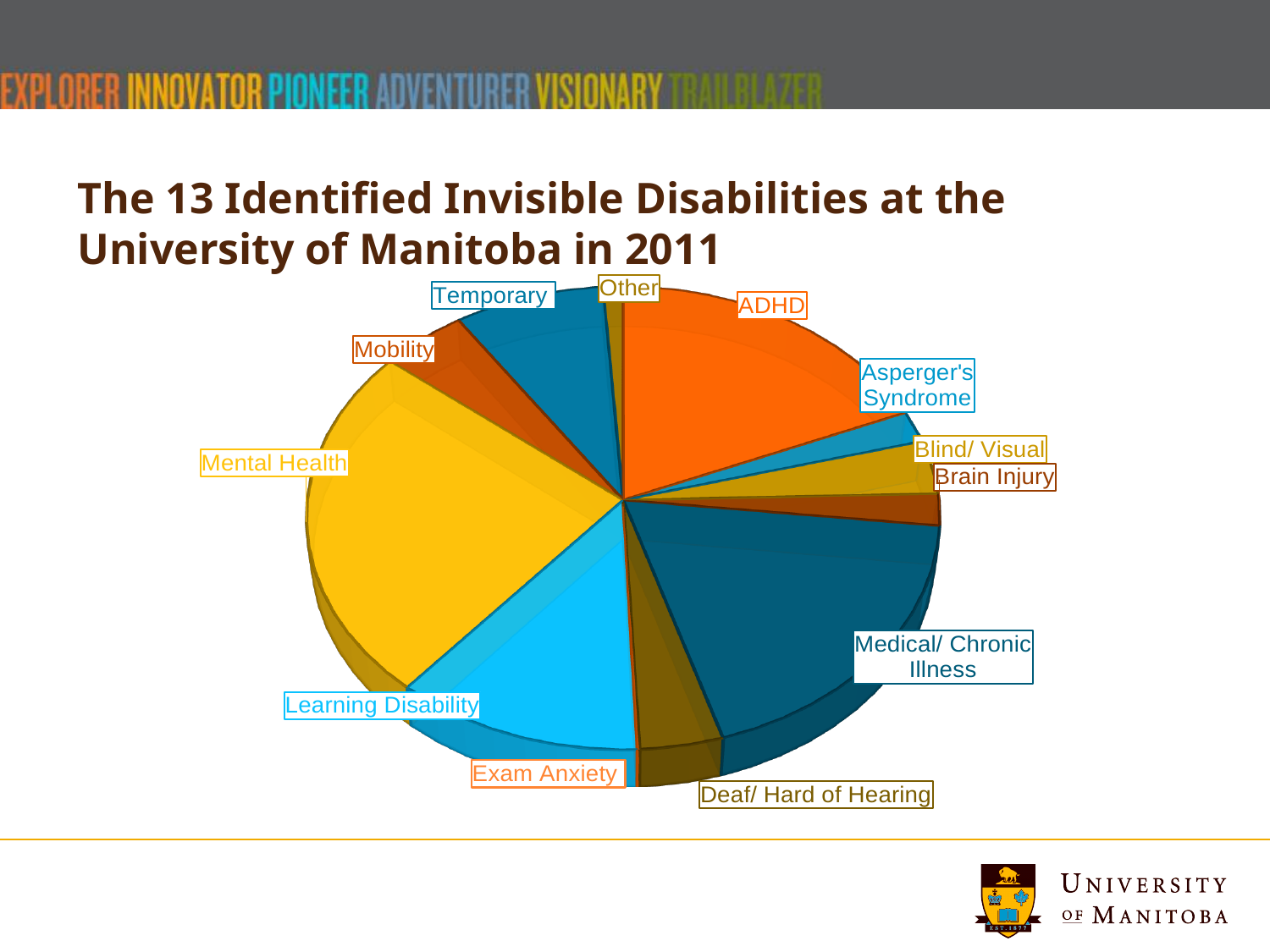
Which slice is larger, Exam Anxiety or Deaf/ Hard of Hearing? Exam Anxiety Which category has the largest slice of the pie? Mental Health Which slice is larger, Learning Disability or Exam Anxiety? Learning Disability Which slice is larger, Mobility or Brain Injury? Mobility What colour is the Mental Health slice of the pie? Yellow Which category has the smallest slice of the pie? Other What is the title of the chart on the slide? The 13 Identified Invisible Disabilities at the University of Manitoba in 2011 What kind of chart is shown on the slide? Pie chart